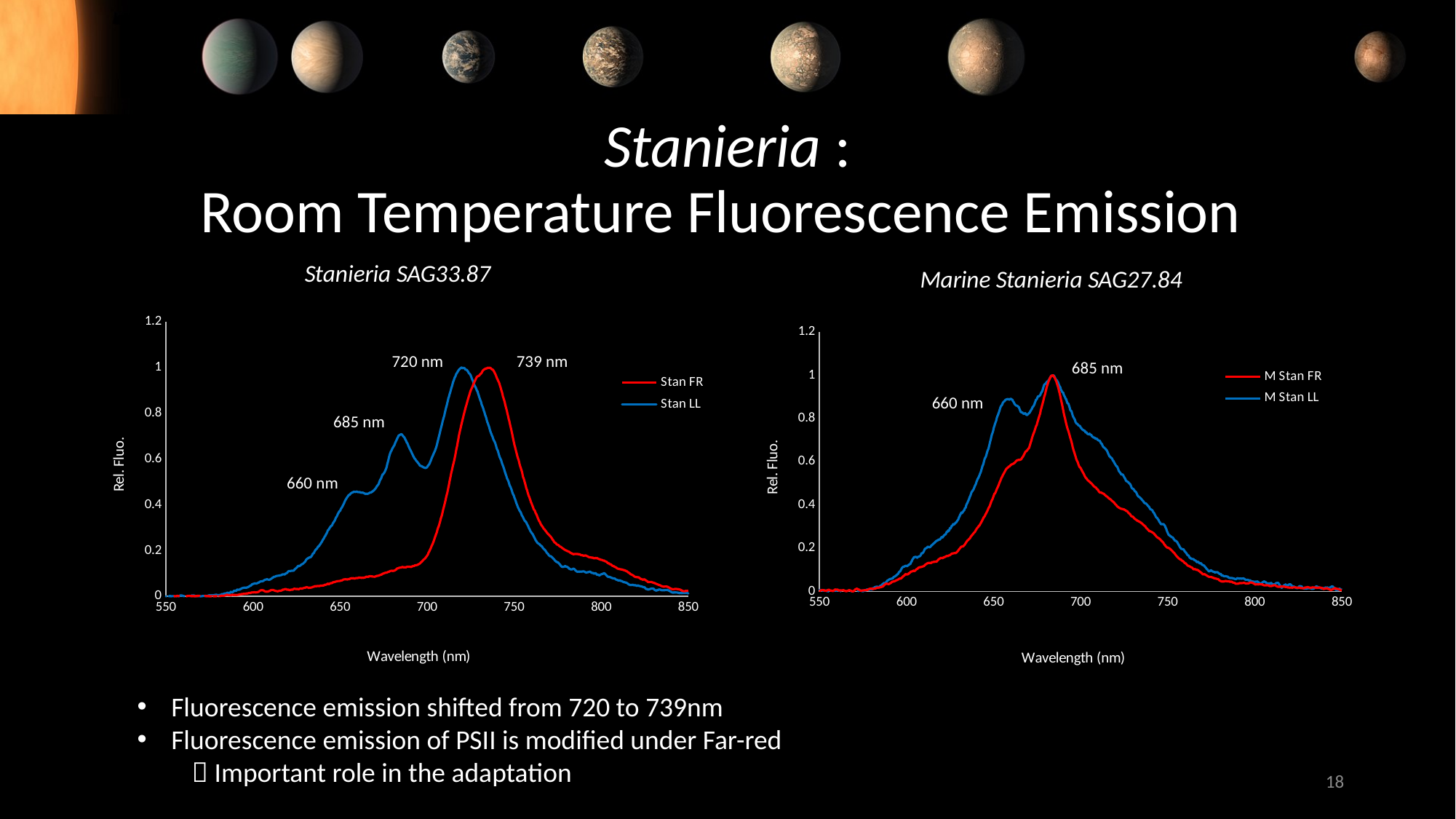
In the Stanieria SAG33.87 chart, which series is drawn in blue? Stan LL In the Marine Stanieria SAG27.84 chart, is the value of M Stan LL at 660 nm greater or less than 0.8? greater How many series does the legend of the Marine Stanieria SAG27.84 chart list? 2 What kind of chart is the Stanieria SAG33.87 chart on the left? line chart In the Stanieria SAG33.87 chart, which series has the higher value at 750 nm, Stan FR or Stan LL? Stan FR What is the x-axis label of the Marine Stanieria SAG27.84 chart? Wavelength (nm) In the Marine Stanieria SAG27.84 chart, which series has the higher value at 720 nm, M Stan FR or M Stan LL? M Stan LL In the Stanieria SAG33.87 chart, is the value of Stan FR at 685 nm greater or less than 0.2? less In the Stanieria SAG33.87 chart, at what wavelength is the peak of the Stan FR curve annotated? 739 nm In the Marine Stanieria SAG27.84 chart, at what wavelength is the main peak annotated? 685 nm In the Stanieria SAG33.87 chart, at what wavelength is the peak of the Stan LL curve annotated? 720 nm In the Stanieria SAG33.87 chart, is the value of Stan LL at 685 nm greater or less than 0.6? greater